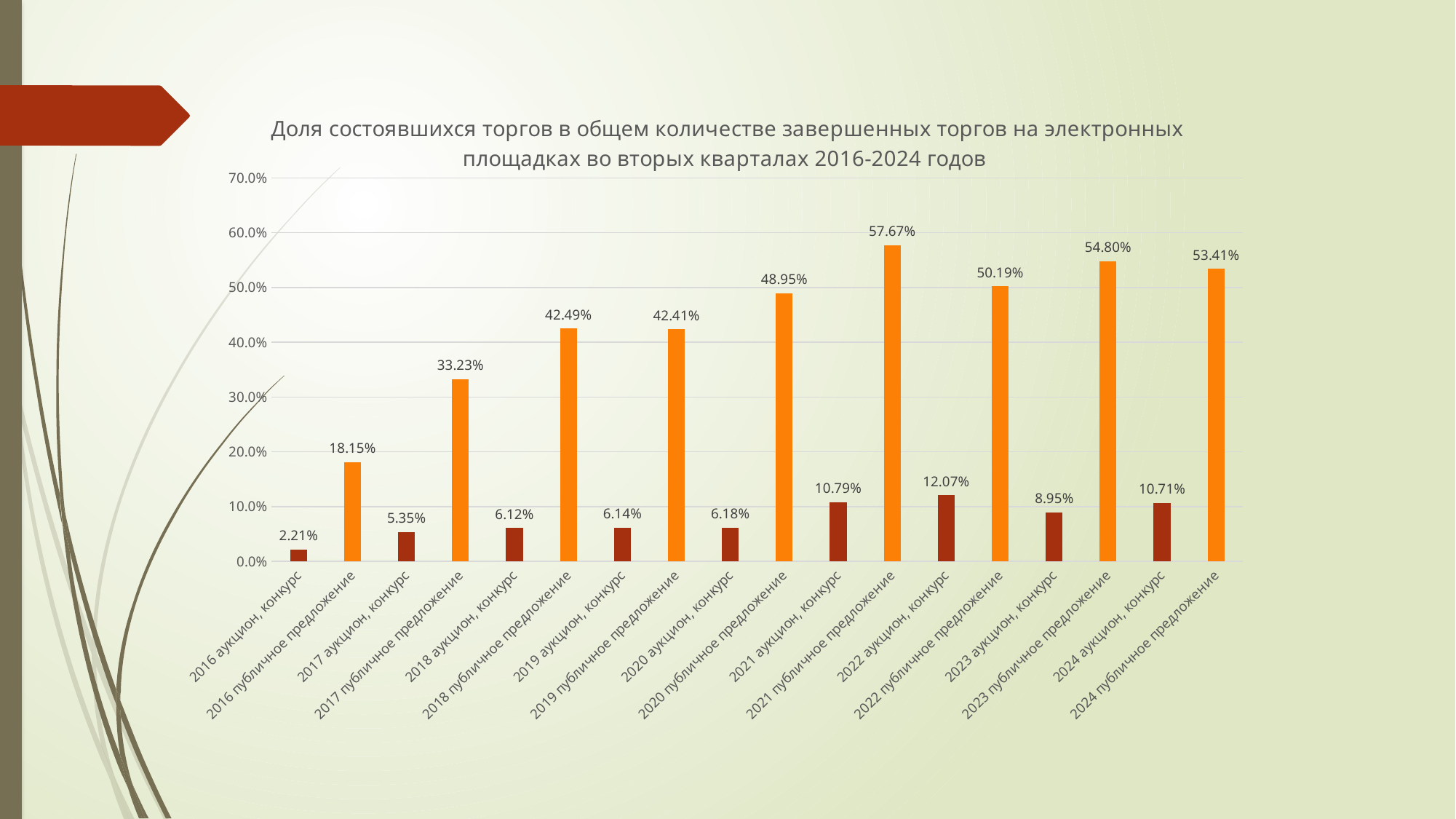
How many categories are shown on the x axis? 18 Which category has the highest value? 2021 публичное предложение Which is larger: the value for 2022 аукцион, конкурс or the value for 2024 аукцион, конкурс? 2022 аукцион, конкурс Do the values for the публичное предложение categories generally rise or fall from 2016 to 2021? Rise What is the value for 2021 публичное предложение? 57.67% What is the value for 2016 аукцион, конкурс? 2.21% What is the value for 2023 аукцион, конкурс? 8.95% What is the difference between the values for 2021 публичное предложение and 2024 публичное предложение? 4.26 percentage points What kind of chart is shown on the slide? Bar chart Which category has the lowest value? 2016 аукцион, конкурс What is the value for 2018 публичное предложение? 42.49% Is the value for 2023 публичное предложение greater or less than 50.0%? greater